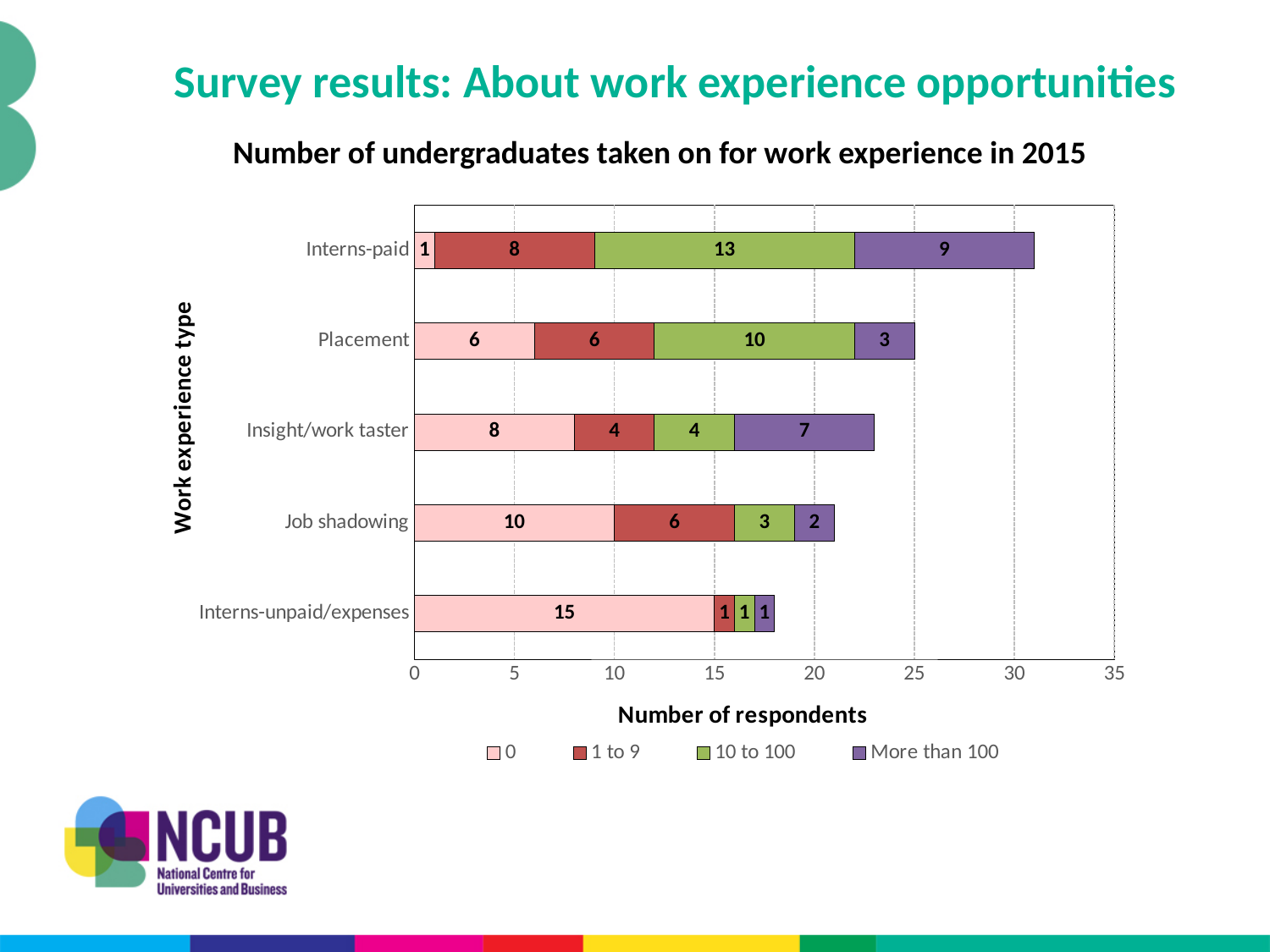
How many work experience types are shown on the chart? 5 Which work experience type has the lowest value for the 'More than 100' series? Interns-unpaid/expenses What is the difference between the '10 to 100' values for Interns-paid and Placement? 3 What is the value for the '1 to 9' series for Job shadowing? 6 What kind of chart is shown on the slide? Stacked bar chart What is the total number of respondents for the Placement bar? 25 What is the value for the 'More than 100' series for Insight/work taster? 7 What is the value for the '0' series for Interns-unpaid/expenses? 15 Which work experience type has the highest value for the '0' series? Interns-unpaid/expenses Which is larger: the 'More than 100' value for Interns-paid or for Placement? Interns-paid What is the value for the '10 to 100' series for Interns-paid? 13 How many series does the legend list? 4